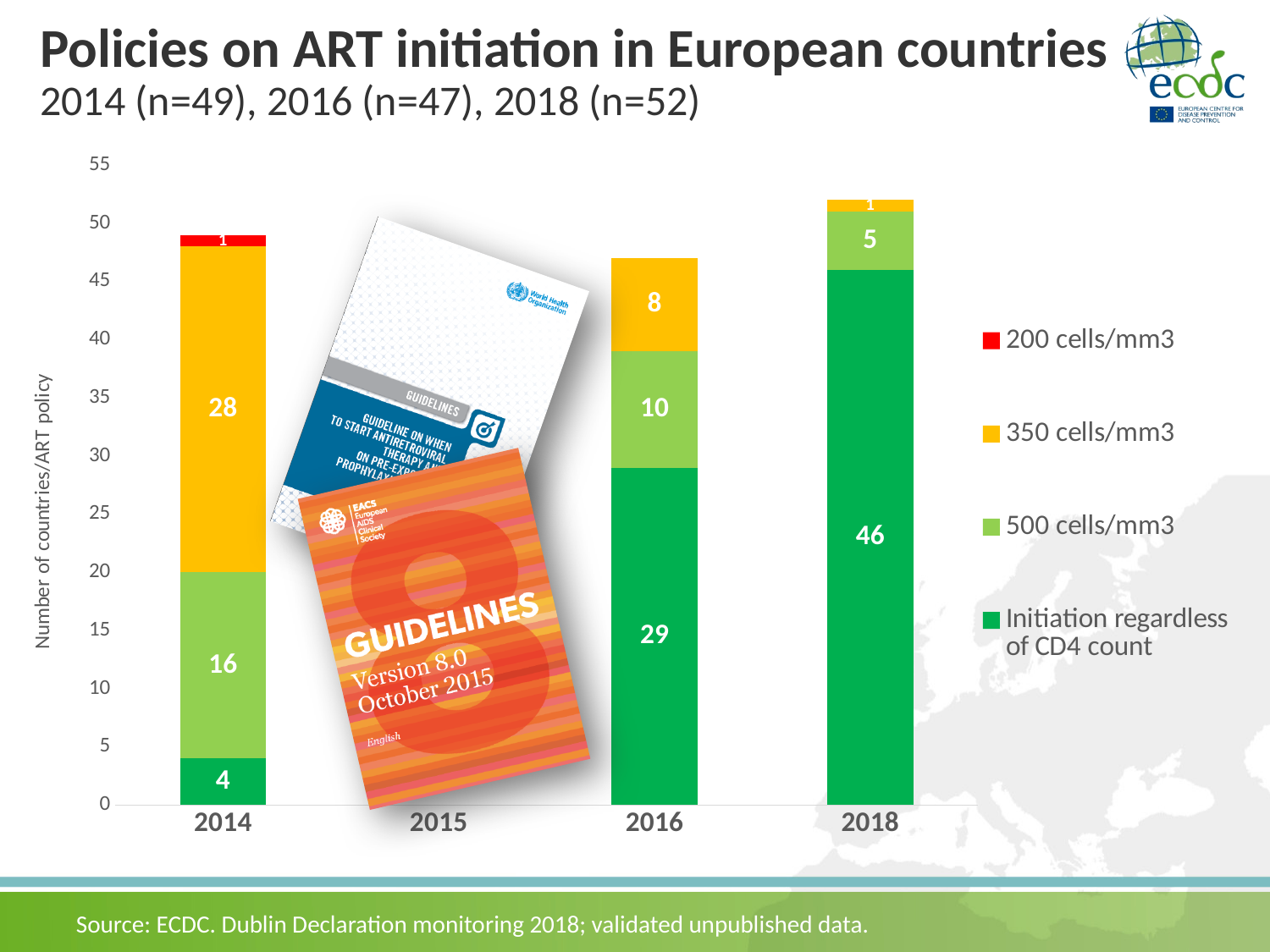
What is the value for '200 cells/mm3' in 2014? 1 What is the total of the stacked bar for 2016? 47 What type of chart is shown on the slide? stacked bar chart What is the difference between the 'Initiation regardless of CD4 count' values for 2018 and 2016? 17 What is the value for '350 cells/mm3' in 2016? 8 What is the value for '500 cells/mm3' in 2018? 5 Which year has the lowest value for 'Initiation regardless of CD4 count'? 2014 Does the value for 'Initiation regardless of CD4 count' rise or fall from 2014 to 2018? rise Which is larger: the '500 cells/mm3' value in 2014 or in 2016? 2014 Which year has the highest value for 'Initiation regardless of CD4 count'? 2018 What is the value for 'Initiation regardless of CD4 count' in 2014? 4 How many series does the legend list? 4